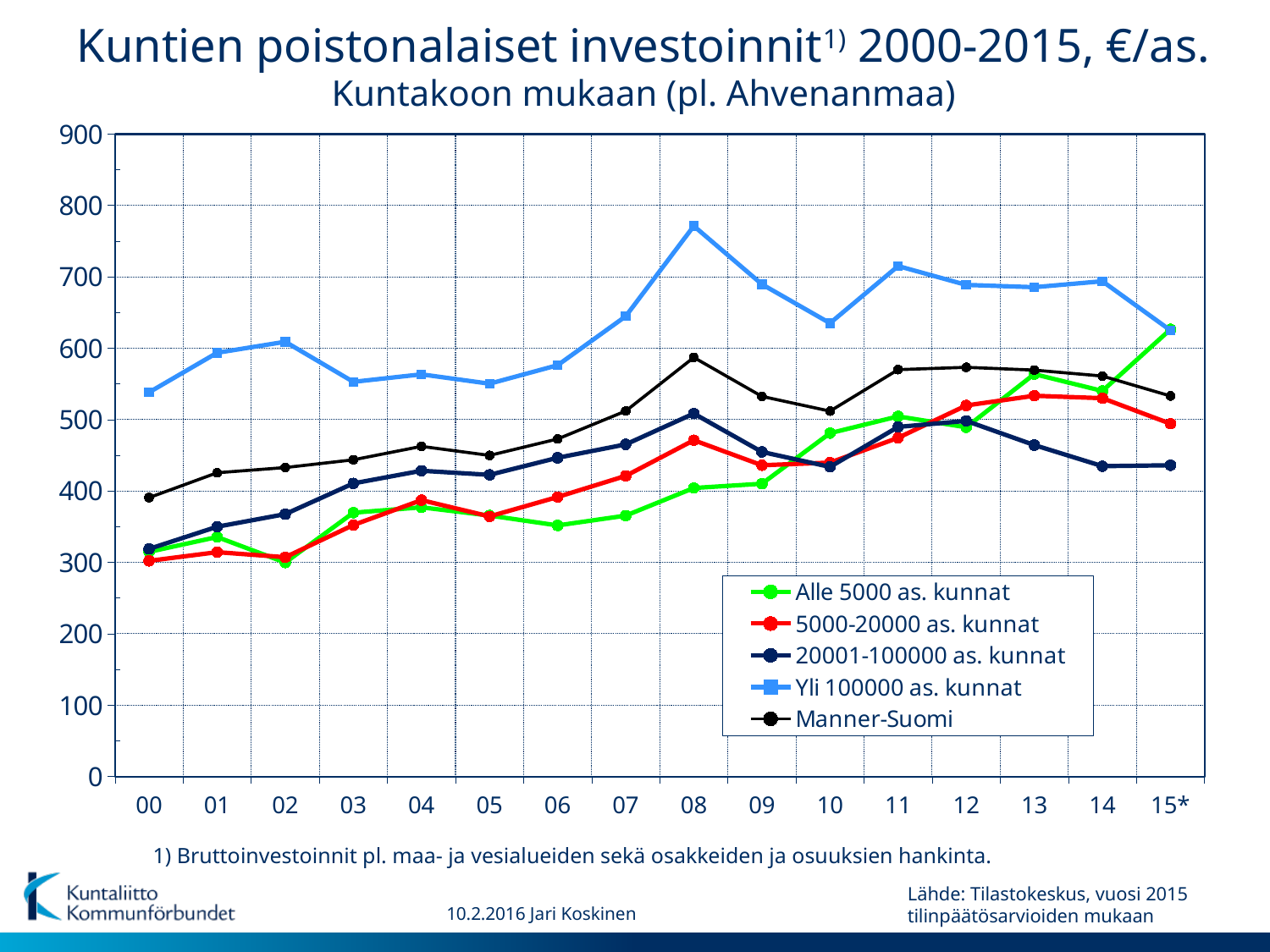
Which series is drawn with light blue square markers? Yli 100000 as. kunnat In 15*, which is larger: 5000-20000 as. kunnat or 20001-100000 as. kunnat? 5000-20000 as. kunnat In which year does the Yli 100000 as. kunnat series reach its highest value? 08 How many years are shown along the x axis? 16 Does the Manner-Suomi series rise or fall from 00 to 08? rise What kind of chart is shown on the slide? line chart In 08, which is larger: Yli 100000 as. kunnat or Manner-Suomi? Yli 100000 as. kunnat Is the value for Manner-Suomi in 00 greater or less than 400? less How many series does the legend list? 5 Is the value for Alle 5000 as. kunnat in 15* greater or less than 600? greater Is the value for Yli 100000 as. kunnat in 08 greater or less than 700? greater Which series has the highest values across the whole period 2000-2015? Yli 100000 as. kunnat